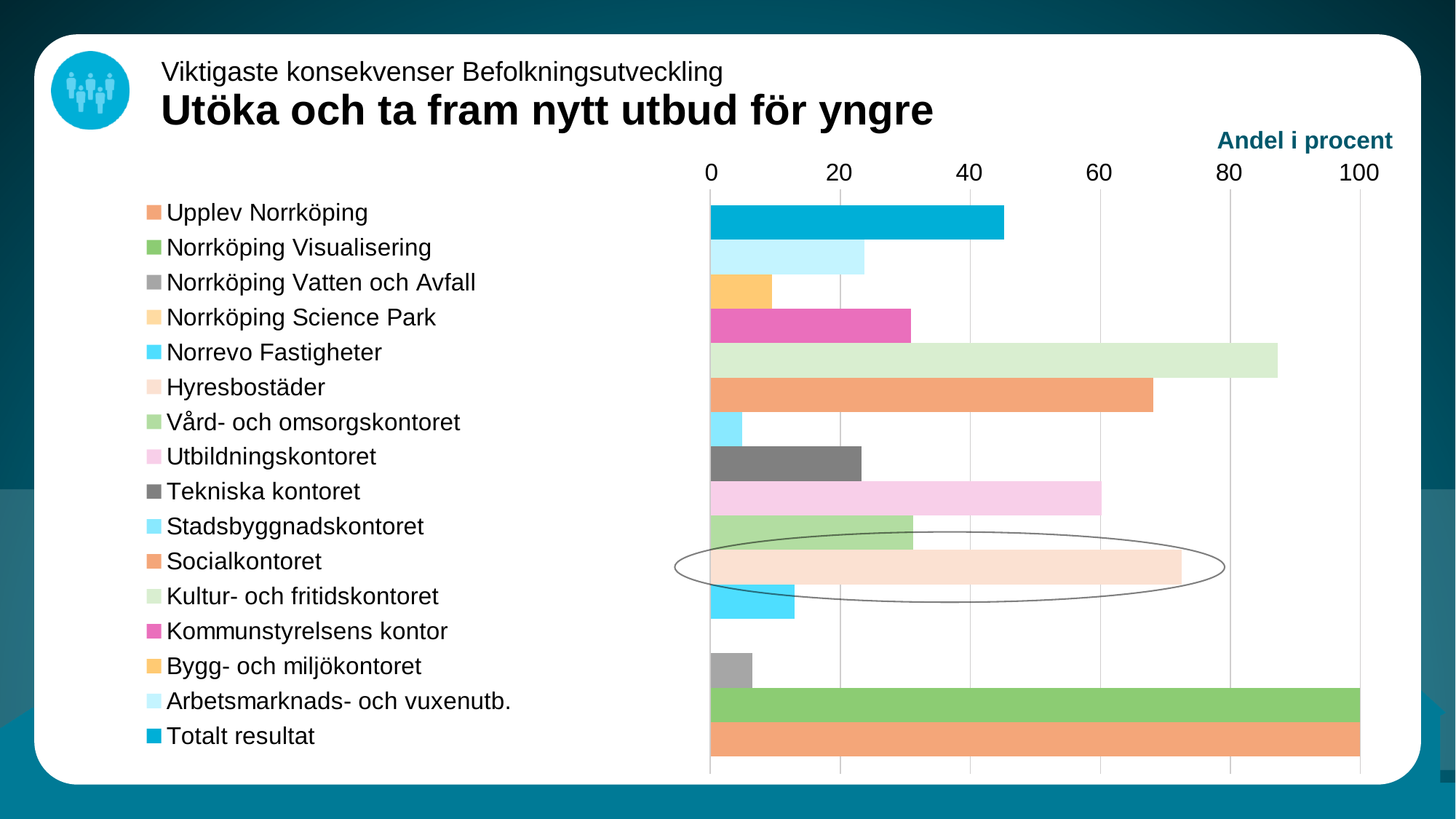
Is the value for Kultur- och fritidskontoret greater or less than 80? greater Is the value for Hyresbostäder greater or less than 60? greater How many entries does the chart legend list? 16 Is the value for Socialkontoret greater or less than 60? greater Which has the larger value, Hyresbostäder or Vård- och omsorgskontoret? Hyresbostäder Which has the larger value, Kultur- och fritidskontoret or Socialkontoret? Kultur- och fritidskontoret What kind of chart is shown on the slide? bar chart What label is shown above the horizontal axis of the chart? Andel i procent Which has the larger value, Kommunstyrelsens kontor or Bygg- och miljökontoret? Kommunstyrelsens kontor